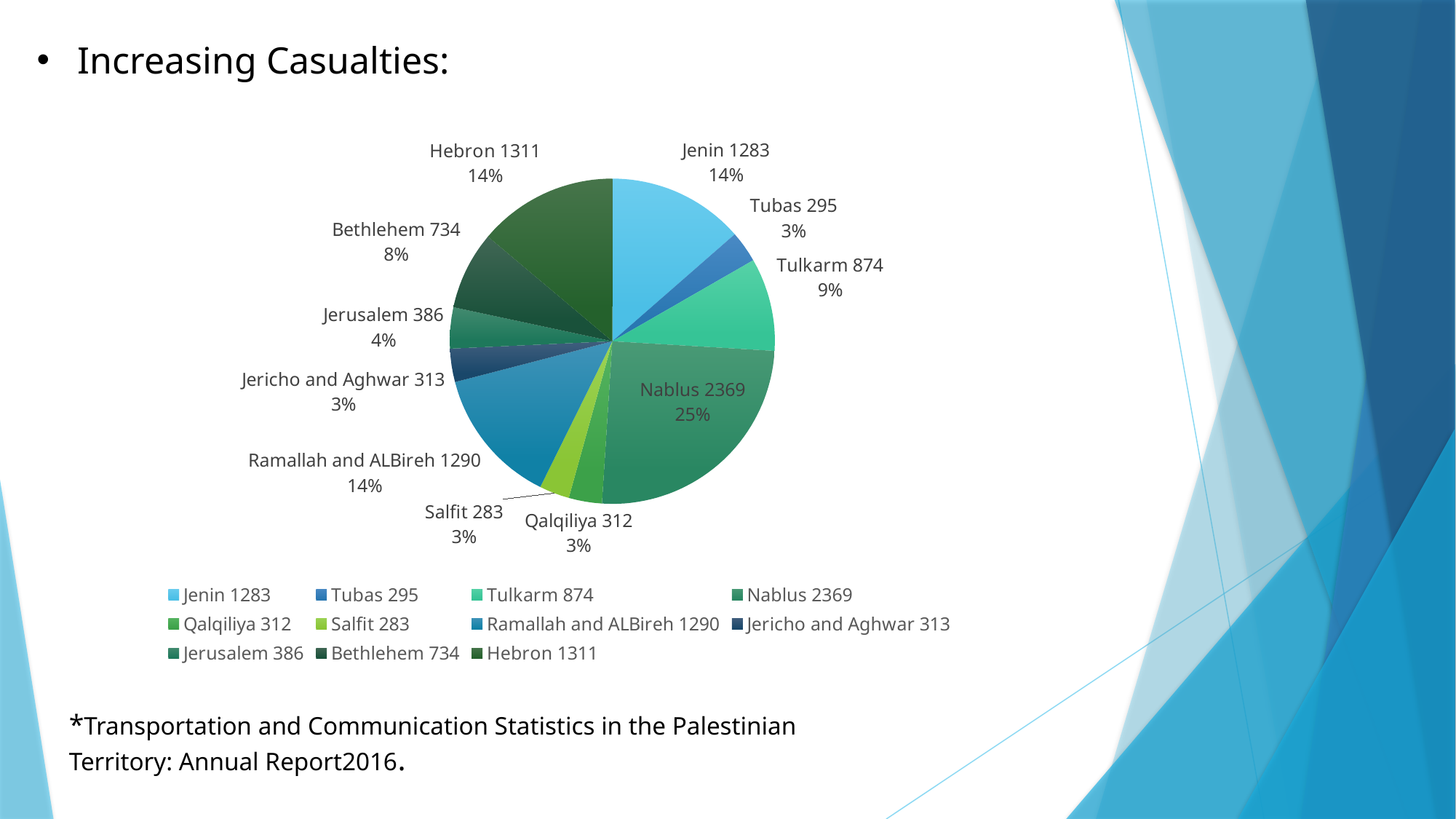
What is the difference between the values for Nablus and Hebron? 1058 Which is larger, the value for Hebron or the value for Jenin? Hebron How many slices does the pie chart have? 11 What value is shown for Nablus in the pie chart? 2369 What value is shown for Tulkarm in the pie chart? 874 What is the bullet text above the pie chart? Increasing Casualties: Which slice of the pie chart has the smallest value? Salfit What share of the pie does Jerusalem represent? 4% What kind of chart is shown on the slide? pie chart What value is shown for Bethlehem in the pie chart? 734 Which slice of the pie chart has the largest value? Nablus What share of the pie does Nablus represent? 25%